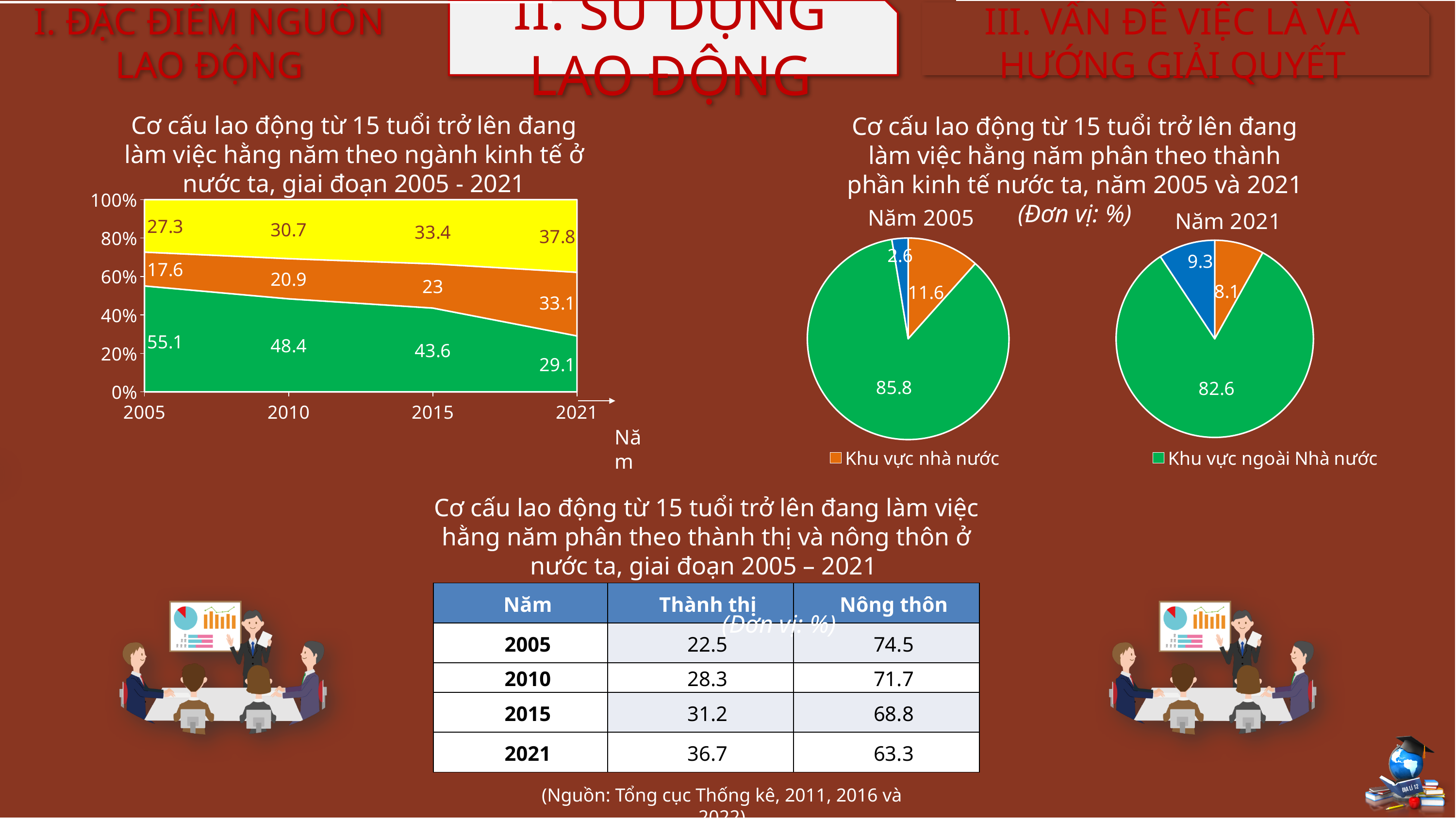
In the stacked area chart on the left, does the green (bottom) series rise or fall from 2005 to 2021? fall In the stacked area chart on the left, by how much does the yellow (top) series increase from 2005 to 2021? 10.5 In the pie chart for Năm 2021, what is the value for Khu vực ngoài Nhà nước? 82.6 In the stacked area chart on the left, what is the value of the green (bottom) series in 2005? 55.1 Is the value for Khu vực nhà nước larger in the Năm 2005 pie chart or the Năm 2021 pie chart? Năm 2005 In the stacked area chart on the left, what is the value of the yellow (top) series in 2021? 37.8 How many years are shown on the x axis of the stacked area chart on the left? 4 How many slices does the pie chart for Năm 2005 have? 3 What kind of chart is the chart on the left of the slide? stacked area chart In the stacked area chart on the left, what is the value of the orange (middle) series in 2015? 23 In the pie chart for Năm 2021, which category has the largest slice? Khu vực ngoài Nhà nước In the pie chart for Năm 2005, what is the value for Khu vực nhà nước? 11.6